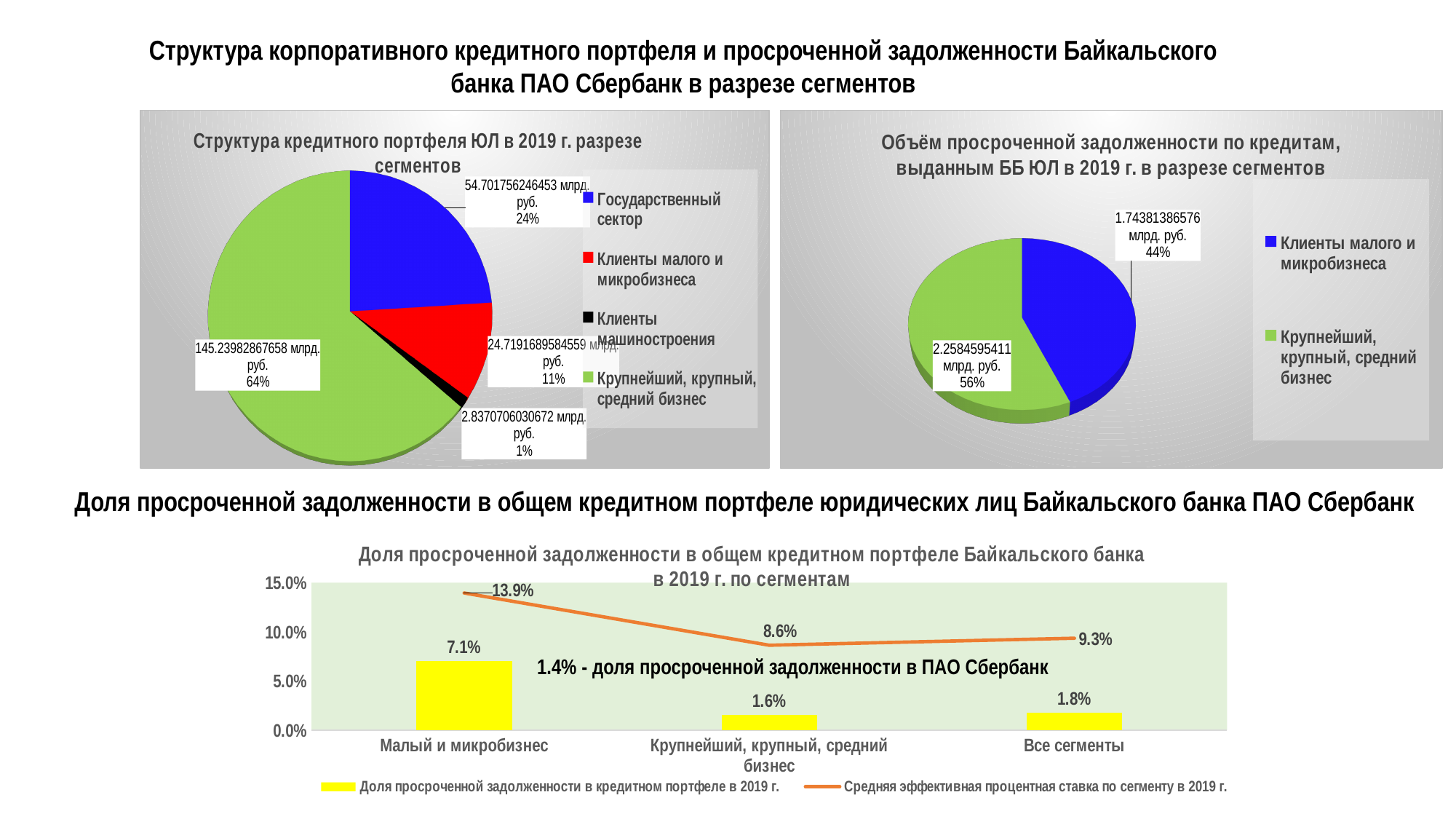
In the pie chart 'Структура кредитного портфеля ЮЛ в 2019 г. разрезе сегментов', what share does 'Крупнейший, крупный, средний бизнес' have? 64% In the bottom chart 'Доля просроченной задолженности в общем кредитном портфеле Байкальского банка в 2019 г. по сегментам', what is the difference between the average effective interest rate for 'Малый и микробизнес' and for 'Крупнейший, крупный, средний бизнес'? 5.3% What type of chart is 'Объём просроченной задолженности по кредитам, выданным ББ ЮЛ в 2019 г. в разрезе сегментов'? Pie chart In the bottom chart 'Доля просроченной задолженности в общем кредитном портфеле Байкальского банка в 2019 г. по сегментам', which category has the highest share of overdue debt? Малый и микробизнес In the pie chart 'Структура кредитного портфеля ЮЛ в 2019 г. разрезе сегментов', which segment has the smallest share? Клиенты машиностроения In the pie chart 'Объём просроченной задолженности по кредитам, выданным ББ ЮЛ в 2019 г. в разрезе сегментов', what share does 'Клиенты малого и микробизнеса' have? 44% In the pie chart 'Объём просроченной задолженности по кредитам, выданным ББ ЮЛ в 2019 г. в разрезе сегментов', which segment is larger? Крупнейший, крупный, средний бизнес In the bottom chart 'Доля просроченной задолженности в общем кредитном портфеле Байкальского банка в 2019 г. по сегментам', what is the share of overdue debt for 'Малый и микробизнес'? 7.1% In the pie chart 'Структура кредитного портфеля ЮЛ в 2019 г. разрезе сегментов', what is the value for 'Государственный сектор'? 54.701756246453 млрд. руб. How many series does the legend of the bottom chart 'Доля просроченной задолженности в общем кредитном портфеле Байкальского банка в 2019 г. по сегментам' list? 2 In the bottom chart 'Доля просроченной задолженности в общем кредитном портфеле Байкальского банка в 2019 г. по сегментам', what is the average effective interest rate for 'Все сегменты'? 9.3% How many segments does the legend of the pie chart 'Структура кредитного портфеля ЮЛ в 2019 г. разрезе сегментов' list? 4